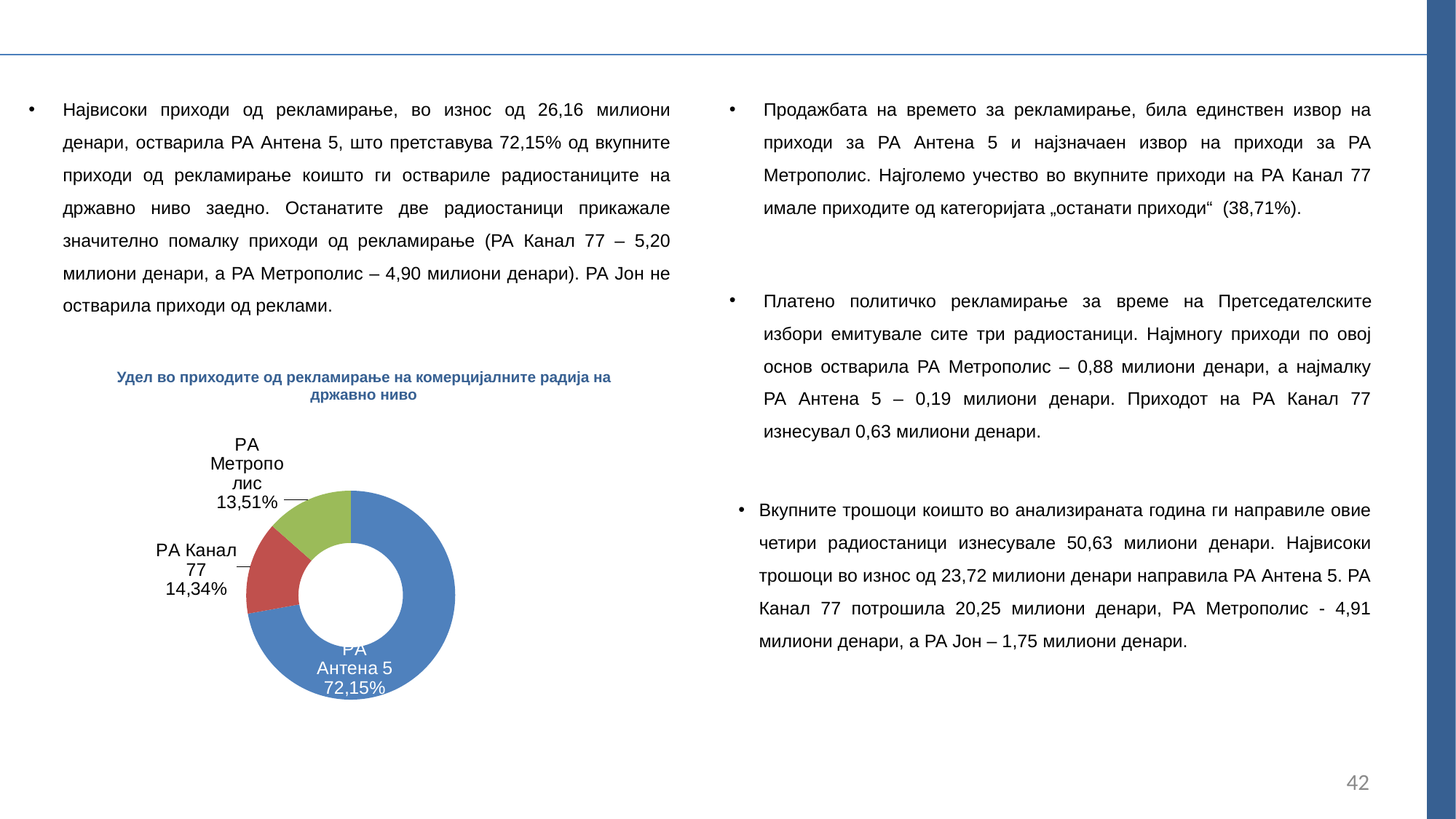
What is the difference in percentage points between the shares of РА Канал 77 and РА Метрополис? 0,83% What share of advertising revenue does РА Антена 5 have in the chart? 72,15% Which radio station has the largest share in the chart? РА Антена 5 What is the difference in percentage points between the shares of РА Антена 5 and РА Канал 77? 57,81% Which radio station has the smallest share in the chart? РА Метрополис Which has the larger share in the chart, РА Канал 77 or РА Метрополис? РА Канал 77 What is the title of the chart on the slide? Удел во приходите од рекламирање на комерцијалните радија на државно ниво What type of chart is shown on the slide? doughnut chart What share does РА Метрополис have in the chart? 13,51% How many radio stations are shown in the chart? 3 What share does РА Канал 77 have in the chart? 14,34% What colour is the slice for РА Антена 5 in the chart? blue